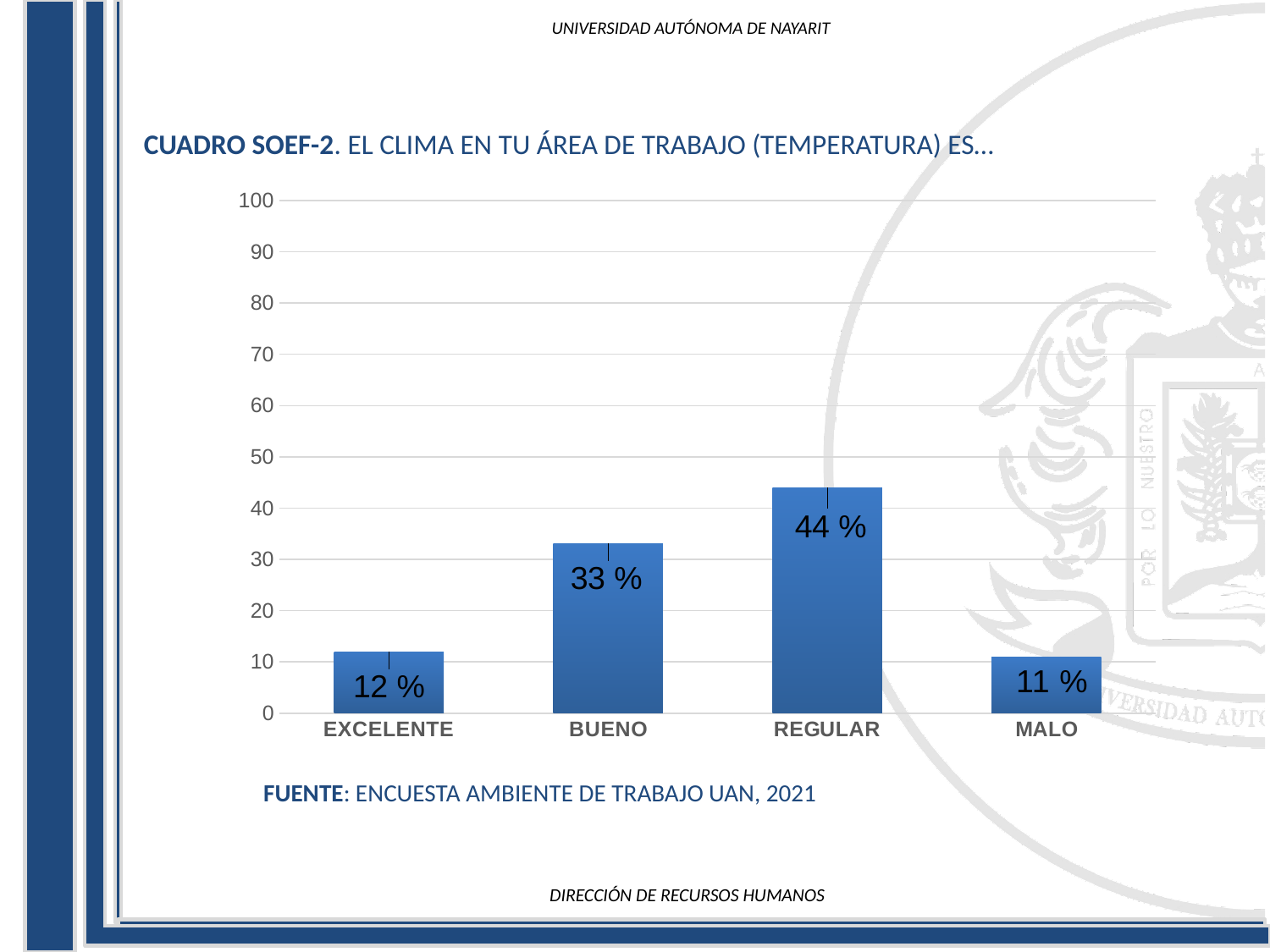
Which category has the highest value? REGULAR What is the value for REGULAR? 44 % What is the source cited below the chart? ENCUESTA AMBIENTE DE TRABAJO UAN, 2021 What is the value for MALO? 11 % What is the difference between the values for REGULAR and BUENO? 11 % What is the value for BUENO? 33 % How many categories are shown on the x axis? 4 Which category has the lowest value? MALO Which is larger, the value for BUENO or the value for EXCELENTE? BUENO What kind of chart is shown on the slide? bar chart Is the value for REGULAR greater or less than 50? less What is the value for EXCELENTE? 12 %